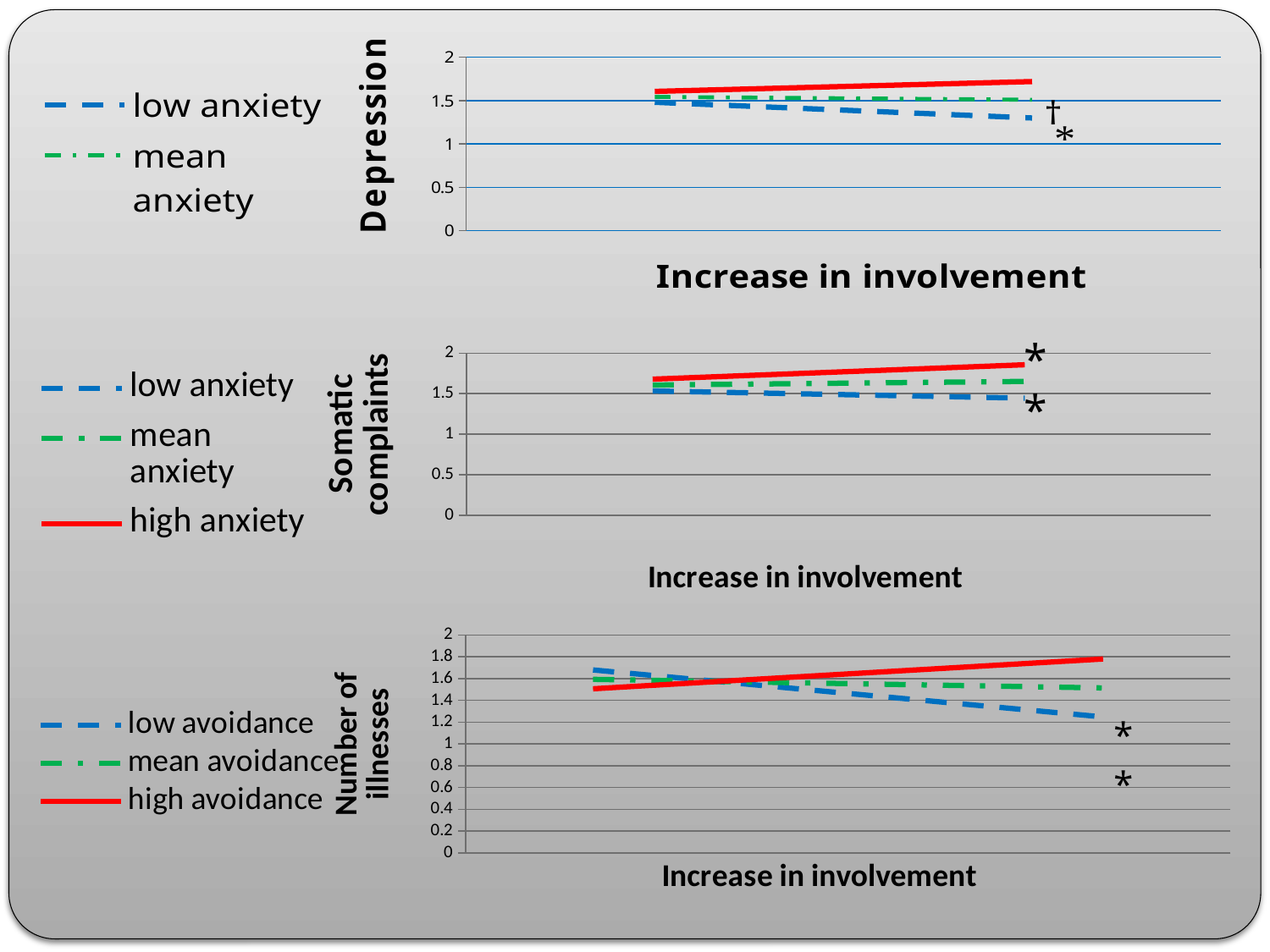
In the Number of illnesses chart, at the right end, which is larger: the high avoidance line or the low avoidance line? high avoidance In the Number of illnesses chart, is the value of the high avoidance line at the right end greater or less than 1.6? greater What kind of chart is the Depression chart at the top of the slide? line chart In the Somatic complaints chart, is the value of the high anxiety line at the right end greater or less than 1.5? greater In the Somatic complaints chart, does the high anxiety line rise or fall along the x axis? rise What is the x-axis title of the Number of illnesses chart? Increase in involvement In the Somatic complaints chart, how many series does the legend list? 3 In the Number of illnesses chart, does the low avoidance line rise or fall along the x axis? fall In the Depression chart, is the value of the high anxiety line at the right end greater or less than 1.5? greater In the Depression chart, does the low anxiety line rise or fall along the x axis? fall